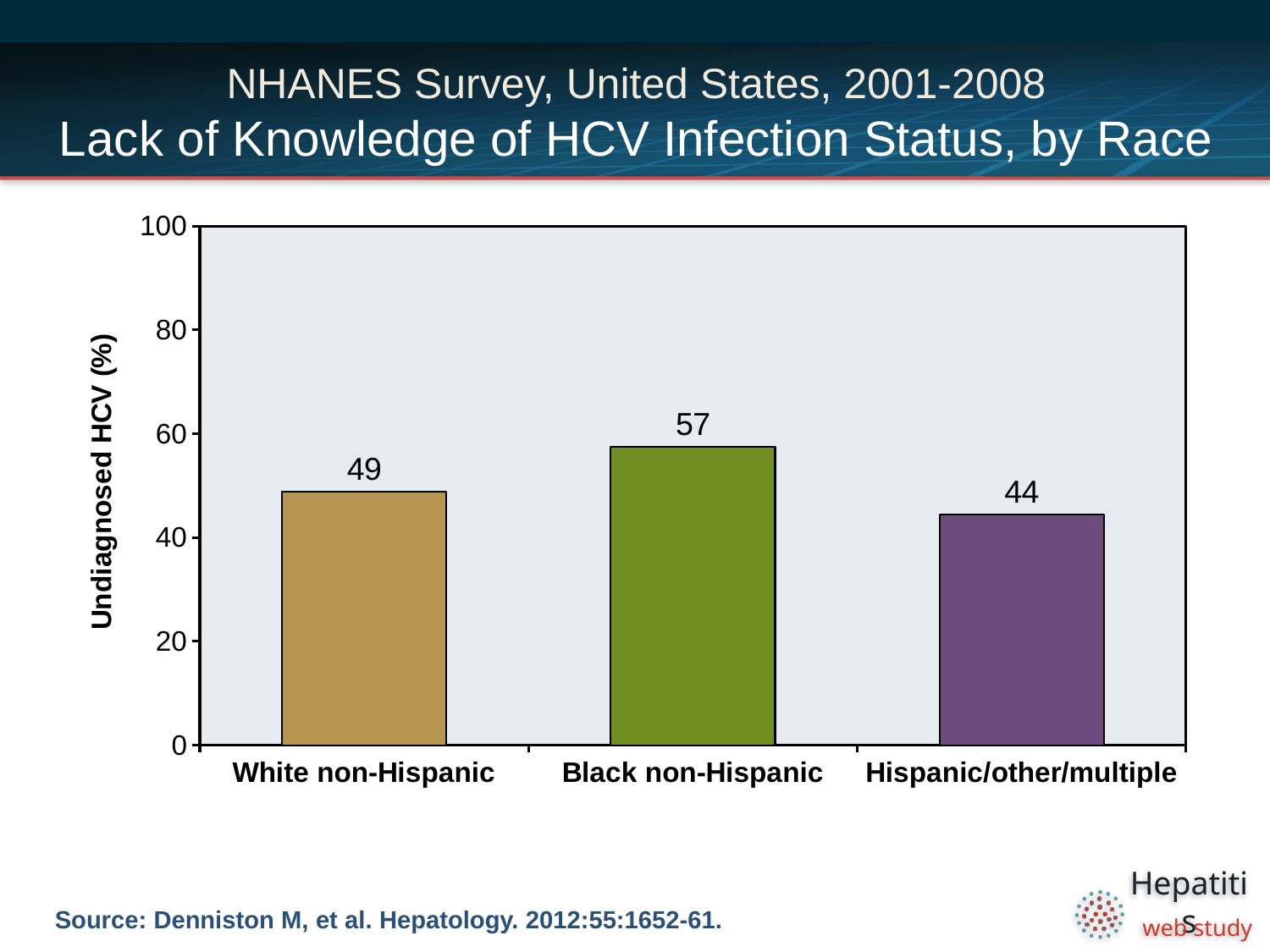
Which has a larger undiagnosed HCV percentage, White non-Hispanic or Hispanic/other/multiple? White non-Hispanic How many race categories are shown in the chart? 3 Is the value for Black non-Hispanic greater or less than 60? less What is the undiagnosed HCV percentage for White non-Hispanic? 49 What is the difference in undiagnosed HCV percentage between White non-Hispanic and Hispanic/other/multiple? 5 What is the label of the y axis? Undiagnosed HCV (%) What is the difference in undiagnosed HCV percentage between Black non-Hispanic and White non-Hispanic? 8 What is the undiagnosed HCV percentage for Hispanic/other/multiple? 44 Which race category has the lowest undiagnosed HCV percentage? Hispanic/other/multiple What kind of chart is shown on the slide? Bar chart What is the undiagnosed HCV percentage for Black non-Hispanic? 57 Which race category has the highest undiagnosed HCV percentage? Black non-Hispanic